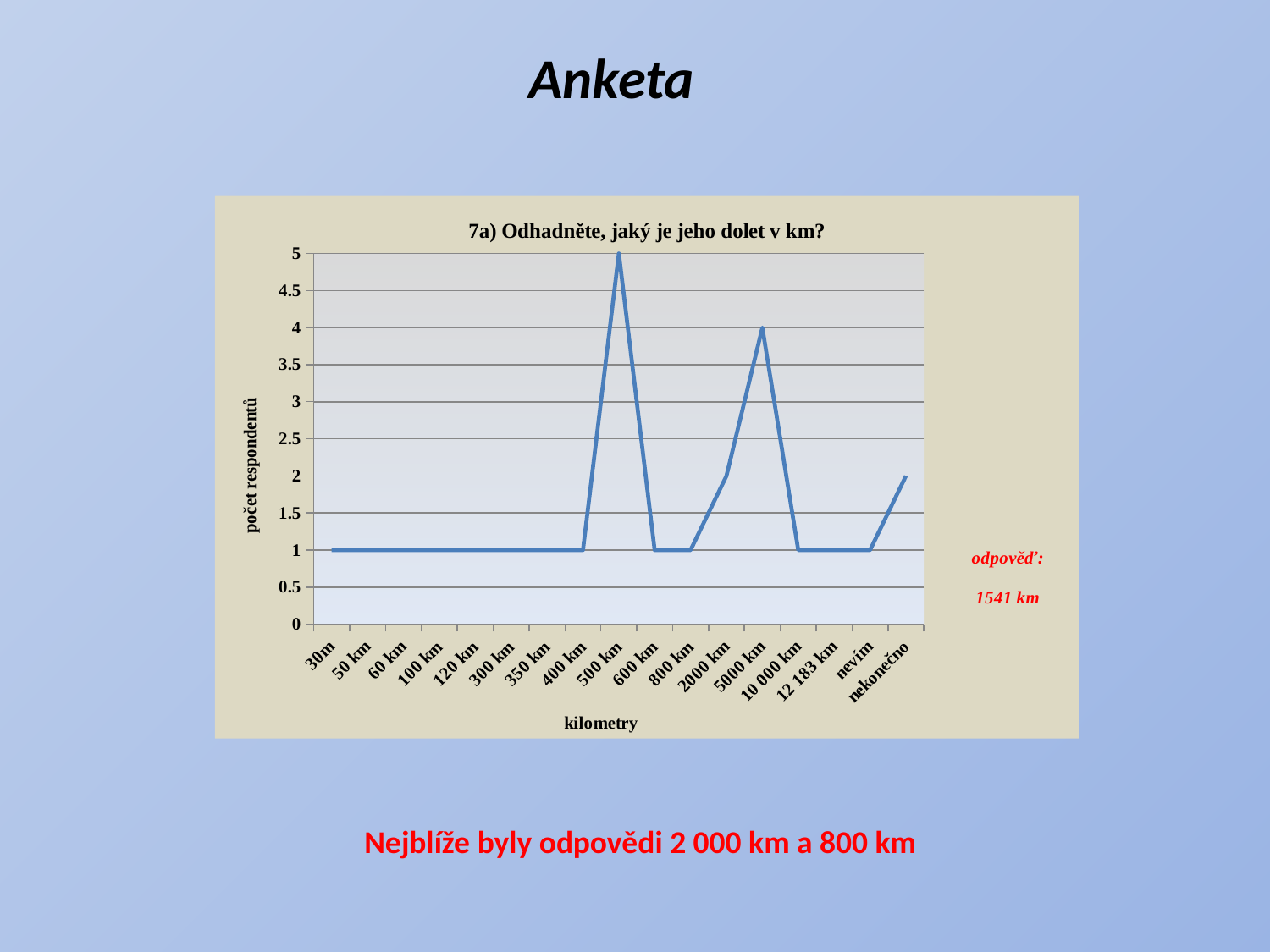
How many respondents chose nekonečno? 2 What is the title of the chart? 7a) Odhadněte, jaký je jeho dolet v km? Is the value for 500 km greater or less than 3? greater How many categories are shown on the x axis? 17 How many respondents chose 2000 km? 2 Which category has the highest number of respondents? 500 km What is the difference between the number of respondents for 500 km and for 5000 km? 1 How many respondents chose 5000 km? 4 What type of chart is shown on the slide? line chart How many respondents chose 500 km? 5 Which has more respondents, 5000 km or 2000 km? 5000 km How many respondents chose 800 km? 1